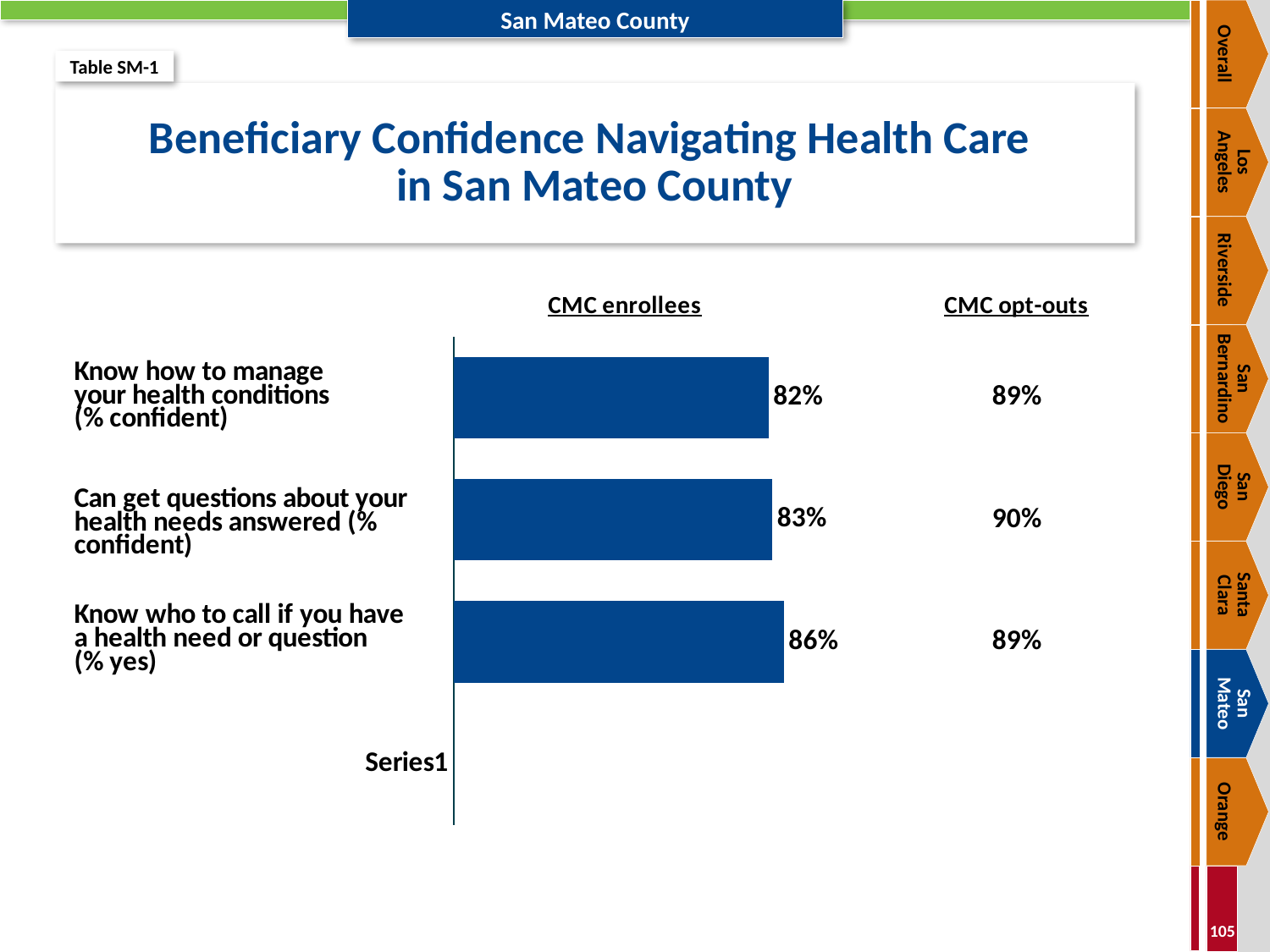
What is the CMC opt-outs value for "Know who to call if you have a health need or question (% yes)"? 89% What kind of chart is shown on the slide? bar chart What is the CMC enrollees value for "Know how to manage your health conditions (% confident)"? 82% What is the CMC enrollees value for "Know who to call if you have a health need or question (% yes)"? 86% What is the CMC enrollees value for "Can get questions about your health needs answered (% confident)"? 83% What is the CMC opt-outs value for "Can get questions about your health needs answered (% confident)"? 90% For "Know who to call if you have a health need or question (% yes)", which group has the larger value, CMC enrollees or CMC opt-outs? CMC opt-outs What is the title of the chart? Beneficiary Confidence Navigating Health Care in San Mateo County Which item has the lowest CMC enrollees value? Know how to manage your health conditions (% confident) How many items are plotted as bars in the chart? 3 Which item has the highest CMC enrollees value? Know who to call if you have a health need or question (% yes) What is the difference between the CMC opt-outs and CMC enrollees values for "Know how to manage your health conditions (% confident)"? 7%